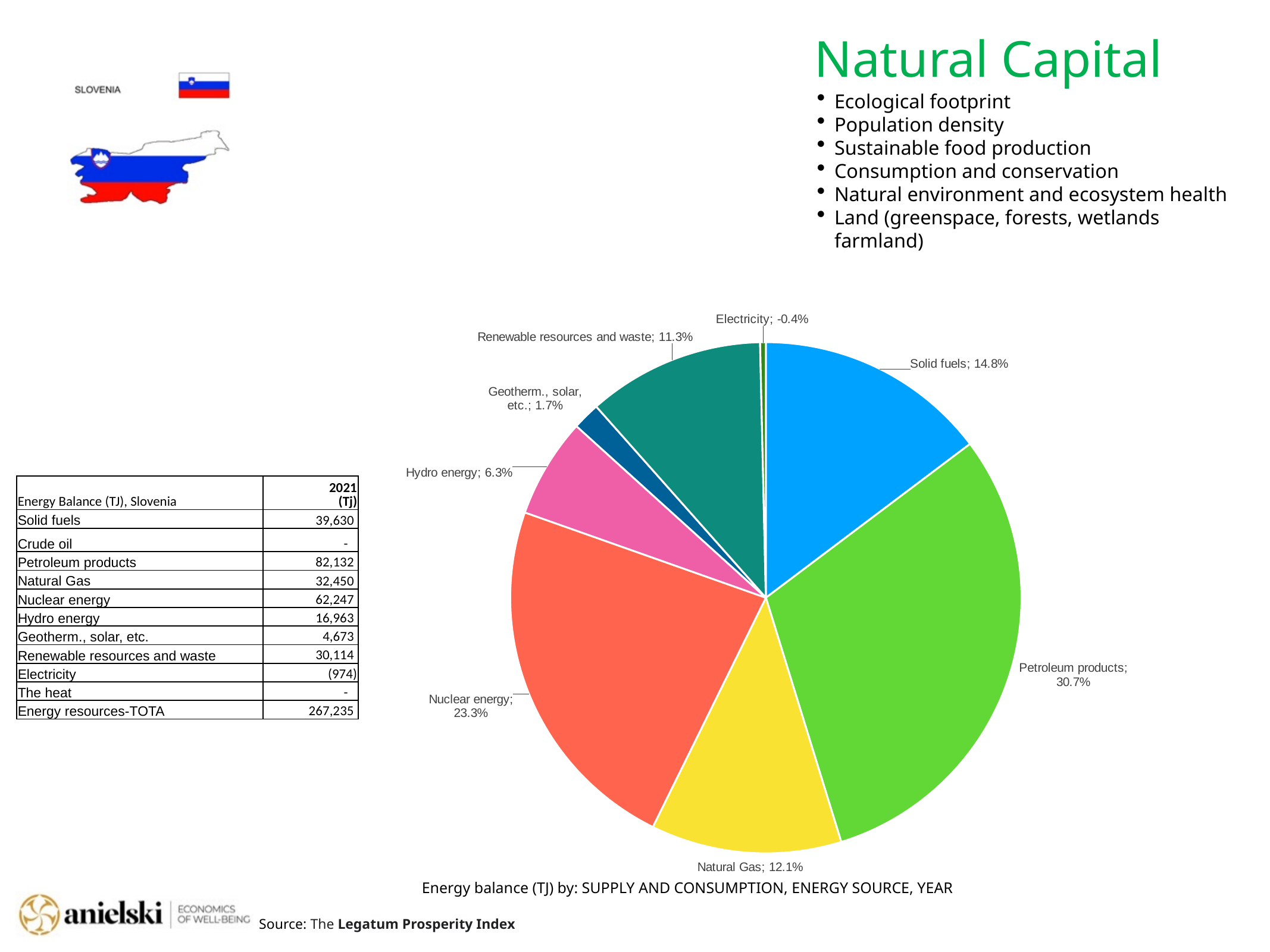
What share of the pie does Petroleum products have? 30.7% What share of the pie does Nuclear energy have? 23.3% What is the title shown below the pie chart? Energy balance (TJ) by: SUPPLY AND CONSUMPTION, ENERGY SOURCE, YEAR Which energy source has the smallest share shown on the pie? Electricity What is the difference in share between Petroleum products and Nuclear energy? 7.4% What type of chart is shown on the slide? pie chart Which has a larger share, Solid fuels or Natural Gas? Solid fuels What share of the pie does Natural Gas have? 12.1% What share of the pie does Solid fuels have? 14.8% What share of the pie does Hydro energy have? 6.3% What share of the pie does Renewable resources and waste have? 11.3% Which energy source has the largest slice of the pie? Petroleum products